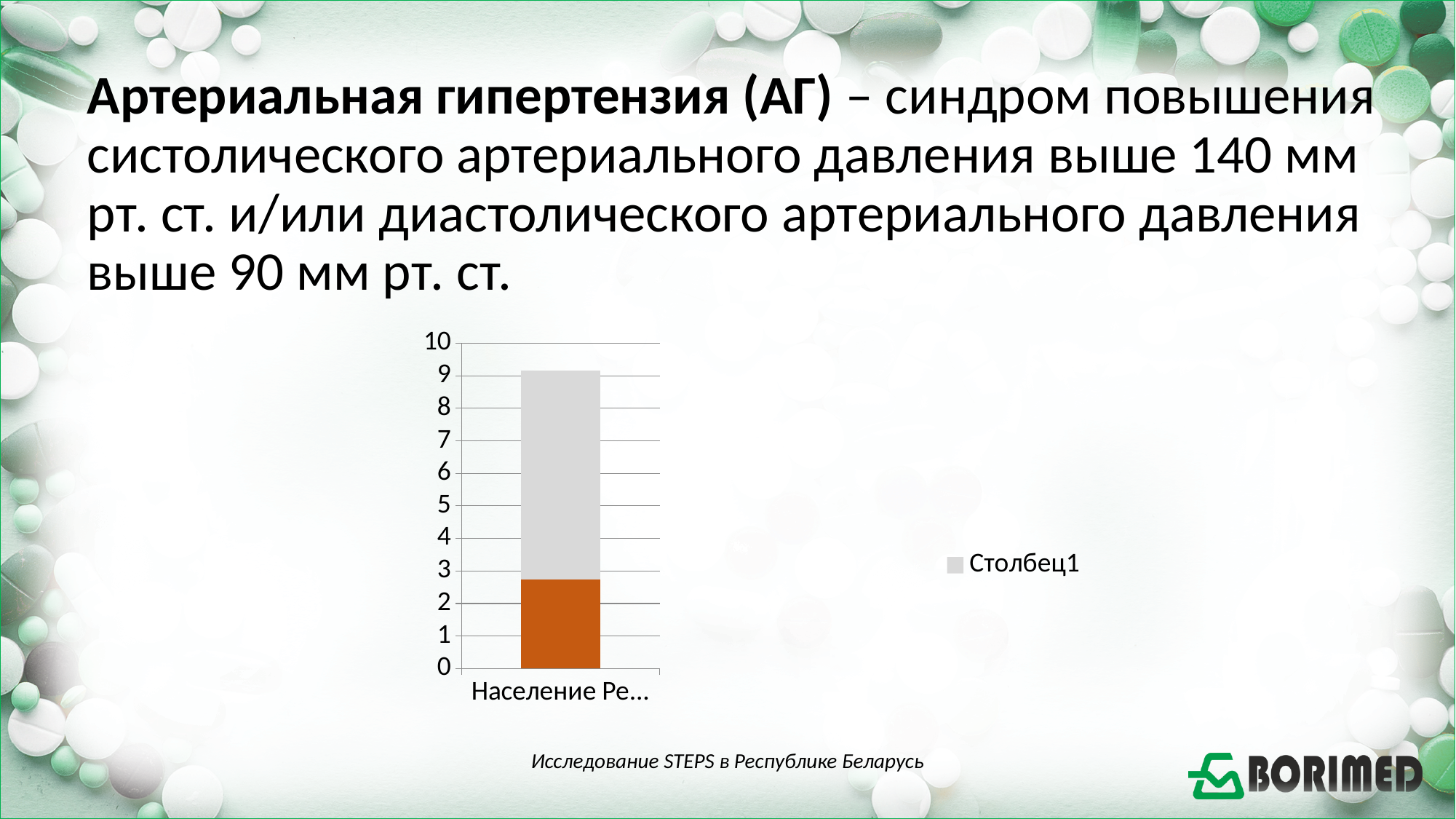
What is the highest value shown on the chart's vertical axis? 10 Which segment of the bar is larger, the grey (top) segment or the orange (bottom) segment? the grey (top) segment Is the value of the orange (bottom) segment of the bar greater or less than 3? less How many categories are plotted on the x axis of the chart? 1 How many series does the chart's legend list? 1 Is the value of the orange (bottom) segment of the bar greater or less than 2? greater Is the total height of the stacked bar greater or less than 8? greater What kind of chart is shown on the slide? bar chart What is the name of the series listed in the chart's legend? Столбец1